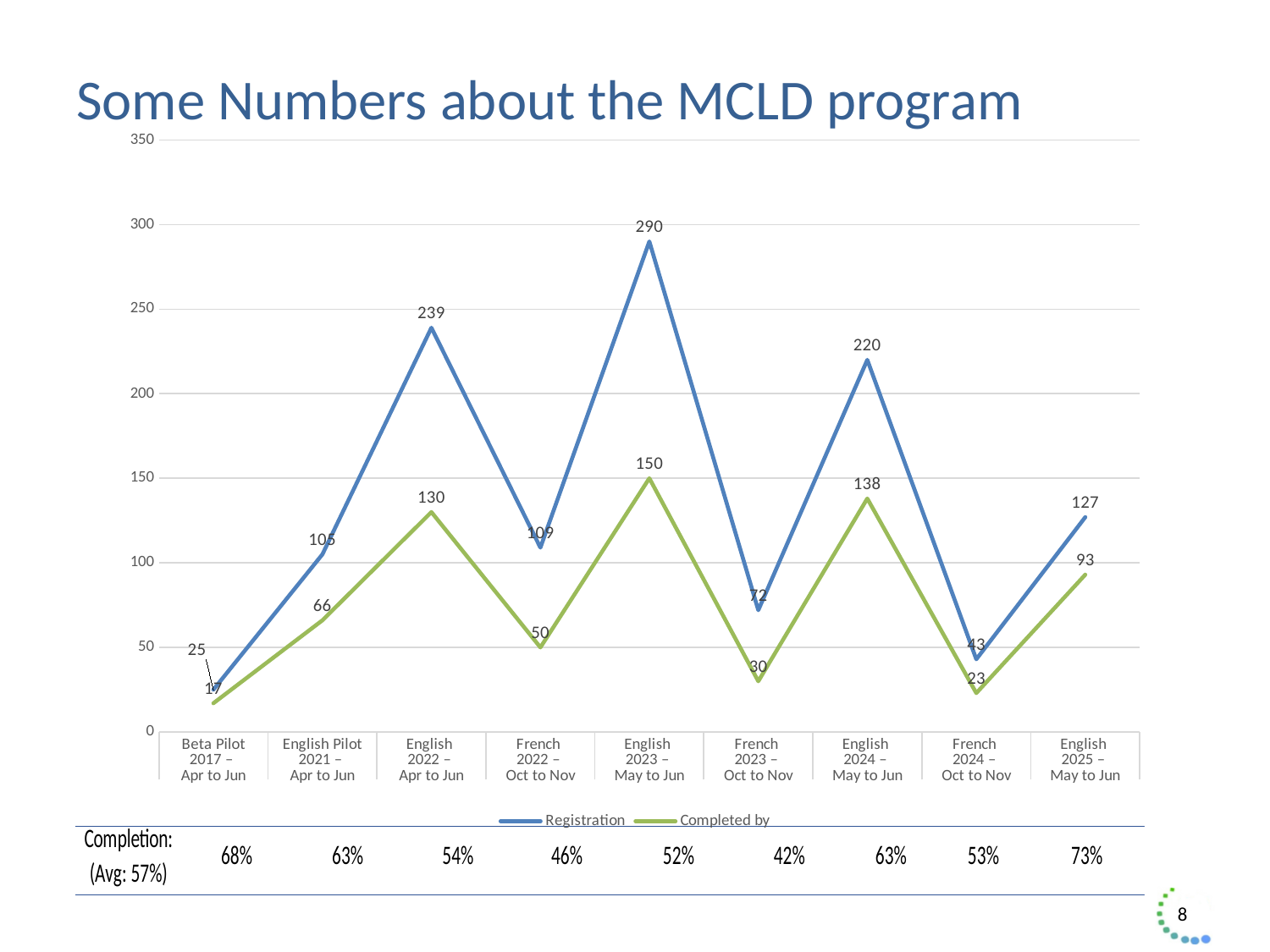
What kind of chart is shown on the slide? line chart What is the Completed by value for English 2025 – May to Jun? 93 What is the Registration value for English 2023 – May to Jun? 290 Which has the larger Completed by value: English 2023 – May to Jun or English 2024 – May to Jun? English 2023 – May to Jun How many categories are plotted along the x axis of the chart? 9 What is the difference between Registration and Completed by for English 2024 – May to Jun? 82 Is the Registration value for English 2022 – Apr to Jun greater or less than 200? greater Which category has the lowest Completed by value? Beta Pilot 2017 – Apr to Jun What are the two series names shown in the chart legend? Registration and Completed by Which category has the highest Registration value? English 2023 – May to Jun What is the Completed by value for English 2022 – Apr to Jun? 130 How many series does the chart legend list? 2